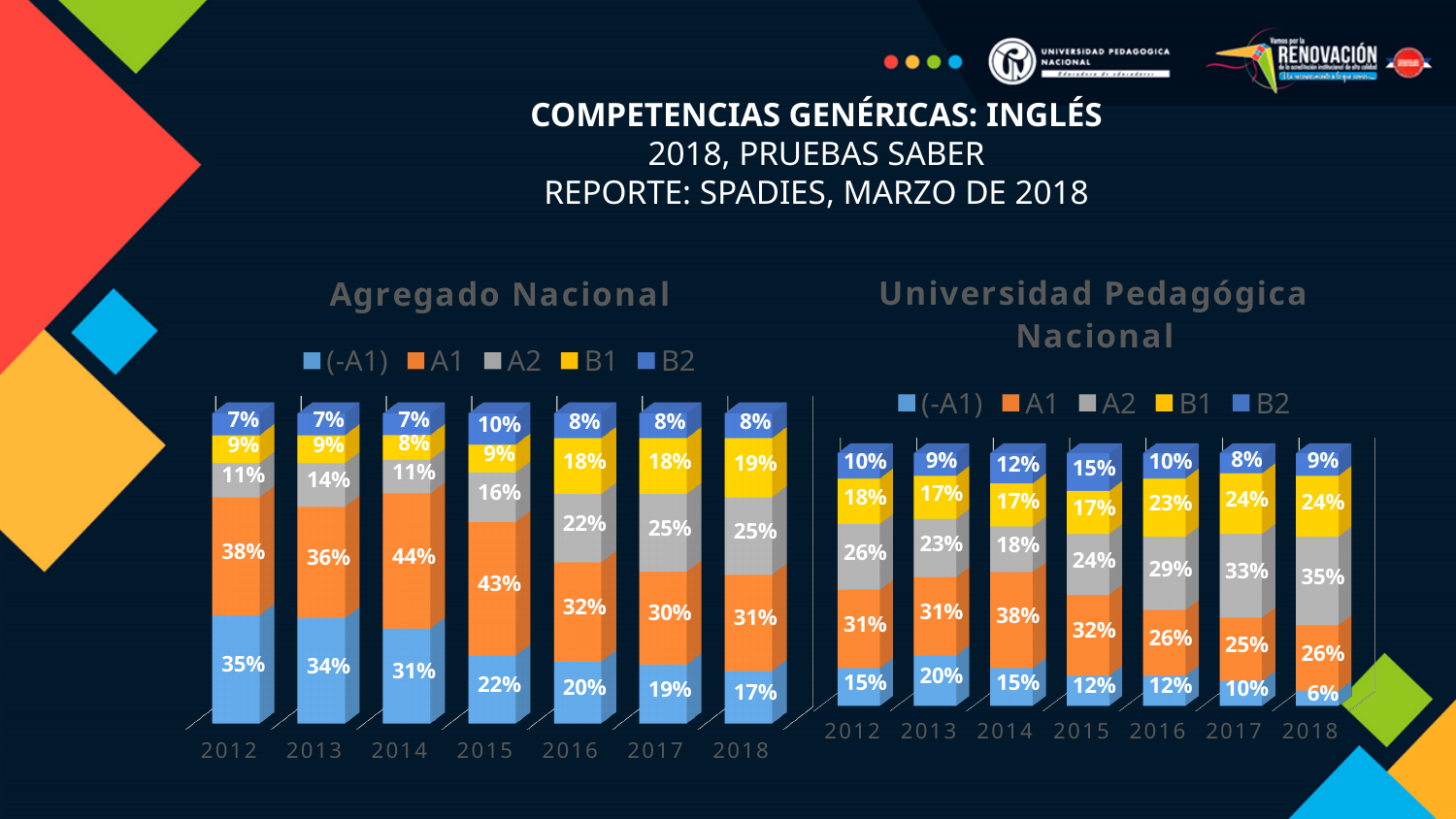
How many series does the legend of the Universidad Pedagógica Nacional chart list? 5 In the Agregado Nacional chart, does the (-A1) series rise or fall from 2012 to 2018? Fall What kind of chart is the Agregado Nacional chart? Stacked bar chart In the Universidad Pedagógica Nacional chart, is the A2 value for 2017 larger or smaller than the A2 value for 2012? larger In the Universidad Pedagógica Nacional chart, which year has the lowest value for the (-A1) series? 2018 In the Agregado Nacional chart, what is the difference between the (-A1) values for 2012 and 2018? 18% In the Universidad Pedagógica Nacional chart, what is the value of the A2 series for 2018? 35% In the Agregado Nacional chart, what is the value of the (-A1) series for 2012? 35% In the Agregado Nacional chart, what is the value of the B1 series for 2018? 19% In the Agregado Nacional chart, which year has the highest value for the A1 series? 2014 How many years are shown on the x axis of the Agregado Nacional chart? 7 In the Universidad Pedagógica Nacional chart, what is the value of the B2 series for 2015? 15%